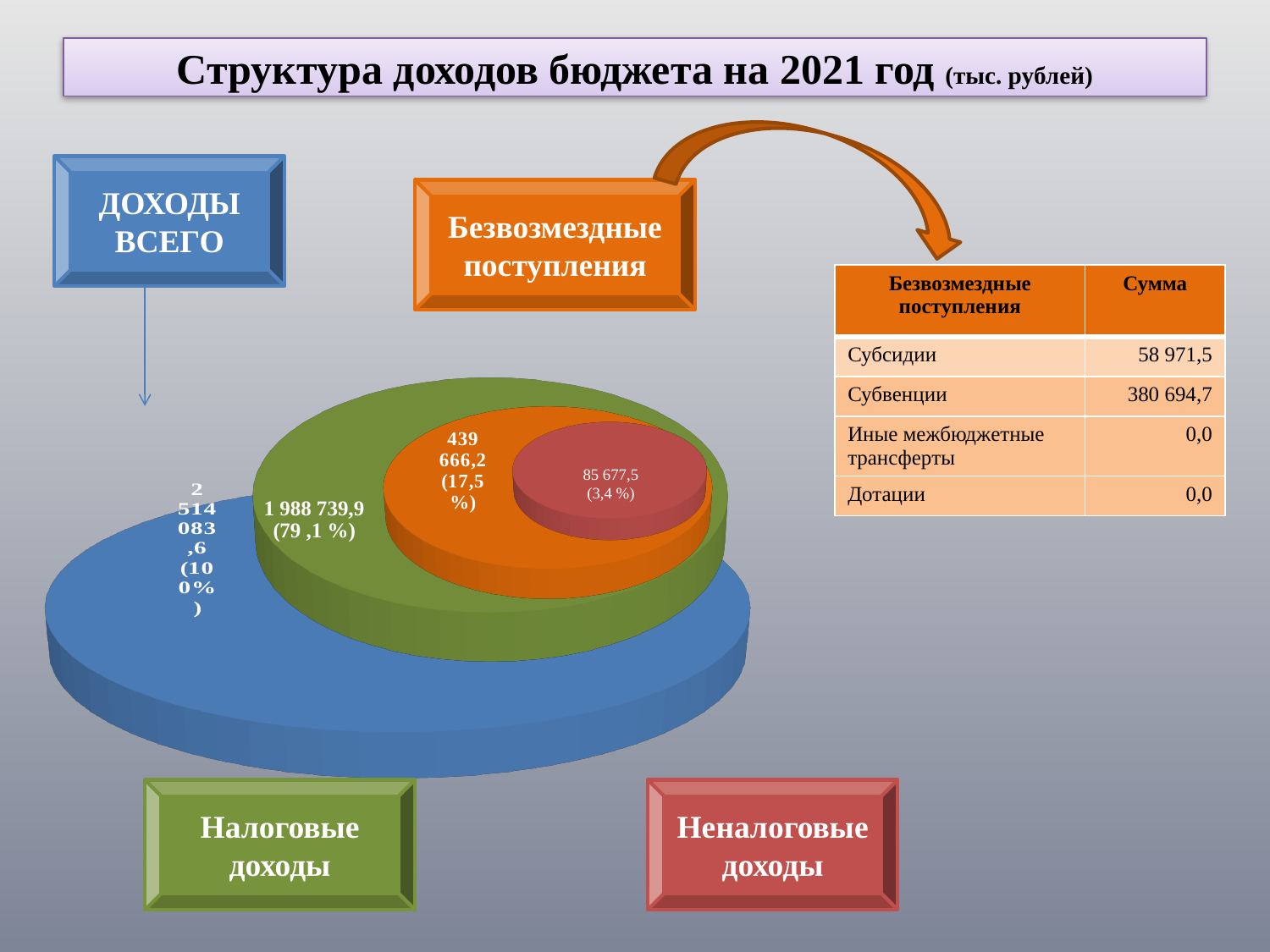
Which revenue component in the diagram has the largest value: Налоговые доходы, Безвозмездные поступления or Неналоговые доходы? Налоговые доходы What is the value shown for Налоговые доходы (green circle) in the nested circle diagram? 1 988 739,9 Which revenue component in the diagram has the smallest value? Неналоговые доходы By how much do Налоговые доходы exceed Безвозмездные поступления in the diagram? 1 549 073,7 Which is larger in the diagram: Безвозмездные поступления or Неналоговые доходы? Безвозмездные поступления What is the value shown for Безвозмездные поступления (orange circle) in the diagram? 439 666,2 What is the total value shown for Доходы всего (blue circle) in the diagram? 2 514 083,6 What share of total revenue do Налоговые доходы make up according to the diagram? 79,1 % What is the value shown for Неналоговые доходы (red circle) in the diagram? 85 677,5 What colour is the circle representing Налоговые доходы in the diagram? Green What share of total revenue do Неналоговые доходы make up according to the diagram? 3,4 % What share of total revenue do Безвозмездные поступления make up according to the diagram? 17,5 %